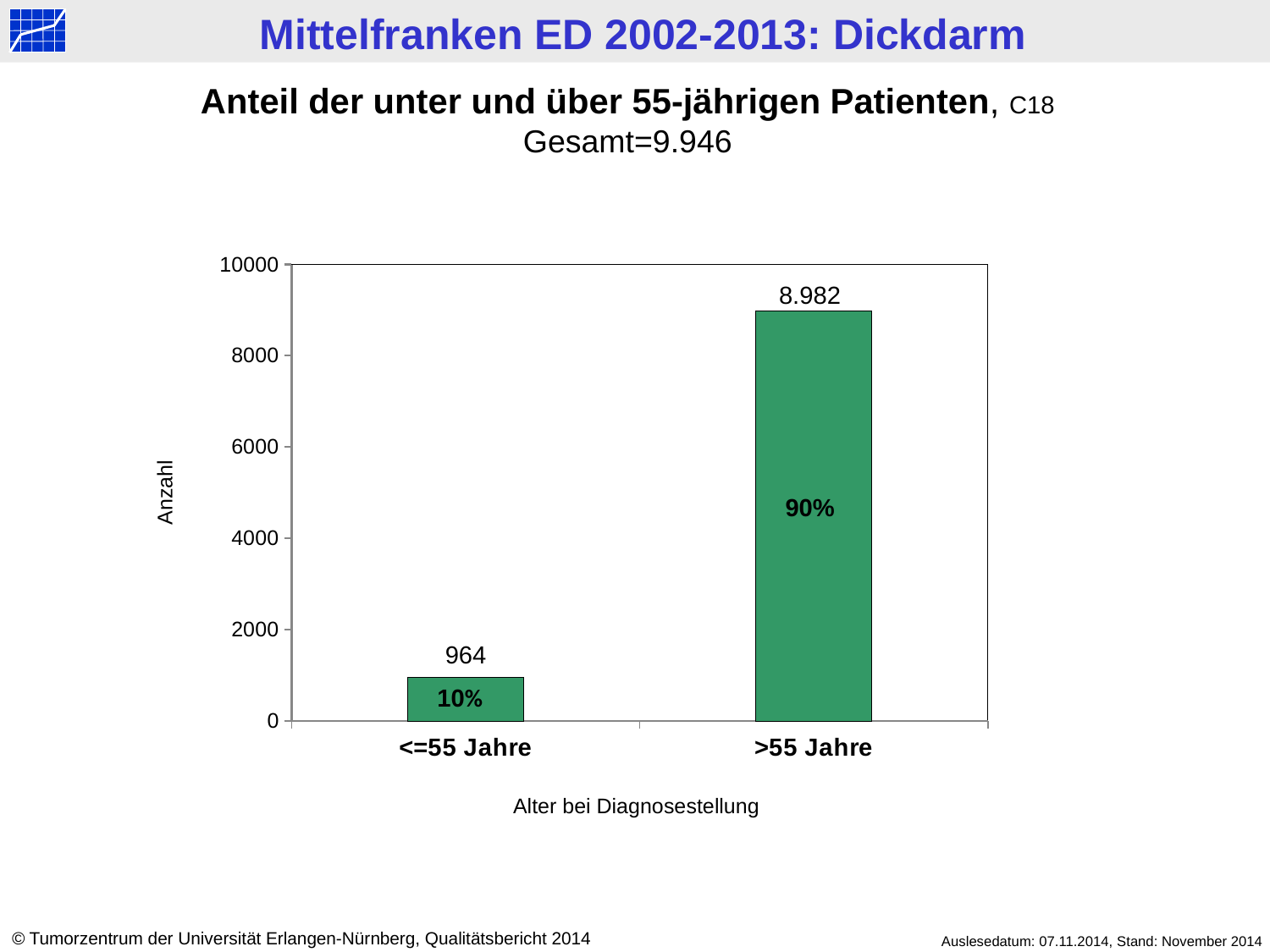
What percentage is shown on the ">55 Jahre" bar? 90% Which category has the highest value? >55 Jahre What is the difference between the values for ">55 Jahre" and "<=55 Jahre"? 8.018 What is the value for the ">55 Jahre" category? 8.982 What is the value for the "<=55 Jahre" category? 964 What is the label of the x axis? Alter bei Diagnosestellung What kind of chart is shown on the slide? bar chart Is the value for ">55 Jahre" greater or less than 8000? greater Which category has the lowest value? <=55 Jahre Is the value for "<=55 Jahre" greater or less than 2000? less What percentage is shown on the "<=55 Jahre" bar? 10% How many categories are shown on the x axis? 2